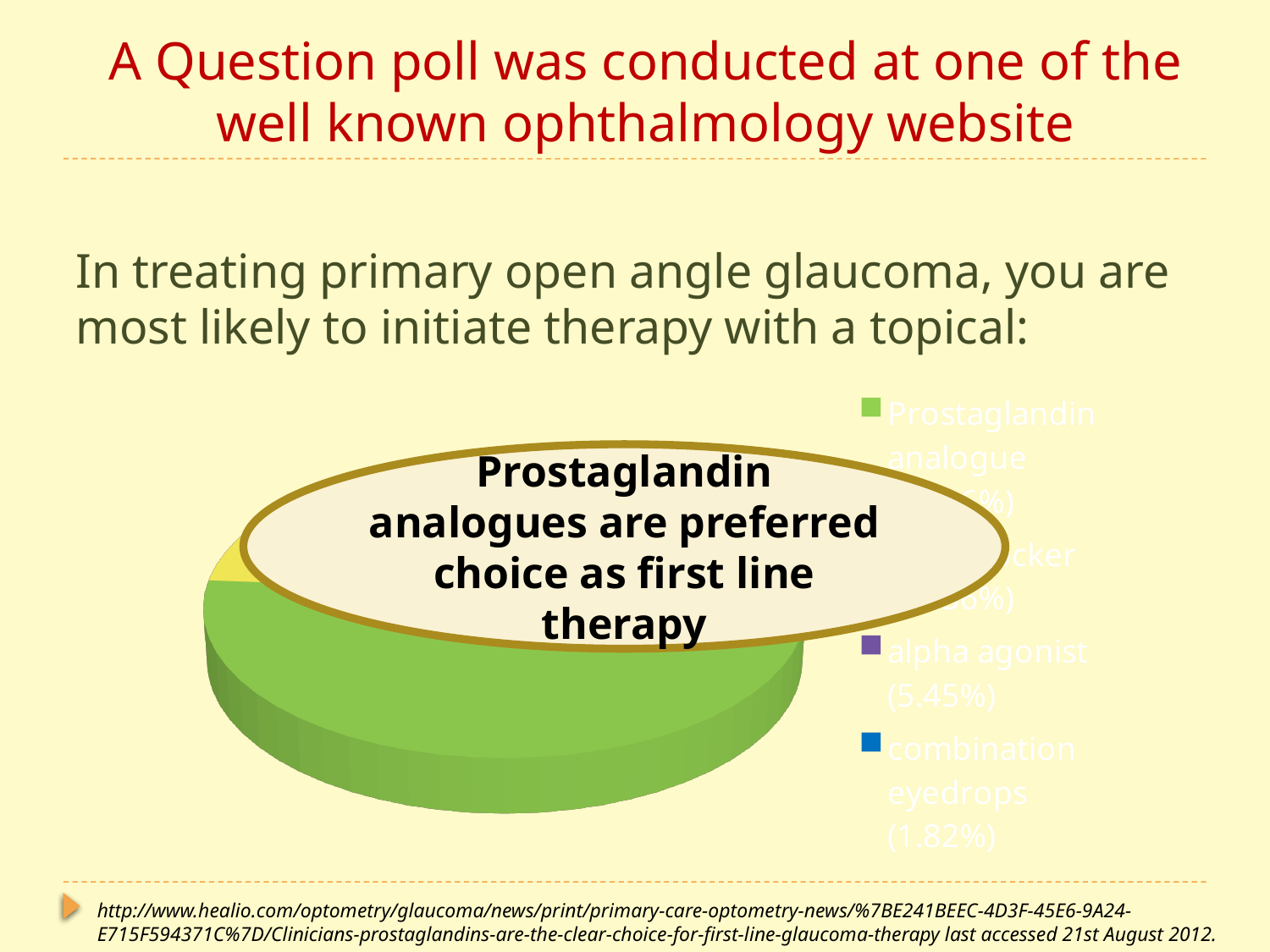
Which is larger, the share for alpha agonist or for combination eyedrops? alpha agonist What percentage is shown in the legend for combination eyedrops? 1.82% What kind of chart is shown on the slide? pie chart What percentage is shown in the legend for alpha agonist? 5.45% What colour is the largest slice of the pie chart? green Which category has the largest slice of the pie chart? Prostaglandin analogue According to the callout on the chart, which drug class is the preferred first-line therapy? Prostaglandin analogues What is the difference between the alpha agonist share and the combination eyedrops share? 3.63% How many categories does the pie chart's legend list? 4